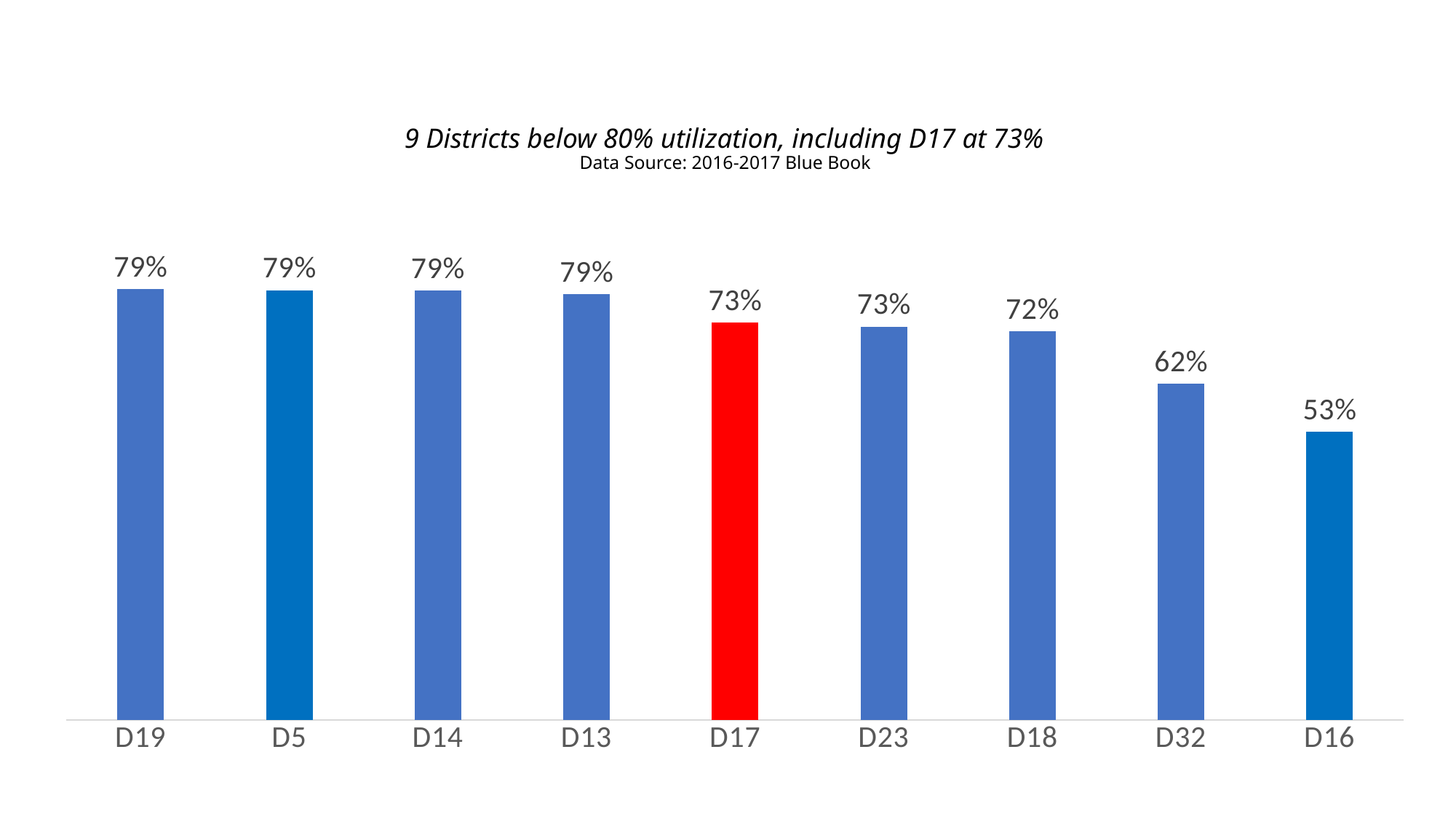
What is the utilization value for D17? 73% Which has a higher utilization, D23 or D32? D23 What kind of chart is shown on the slide? Bar chart How many districts are shown in the chart? 9 Which district's bar is highlighted in red? D17 Do the values rise or fall from left to right along the x axis? Fall What is the utilization value for D16? 53% What is the utilization value for D32? 62% What is the difference between the utilization of D19 and D16? 26% What is the difference between the utilization of D17 and D32? 11% Which district has the lowest utilization? D16 What is the utilization value for D18? 72%